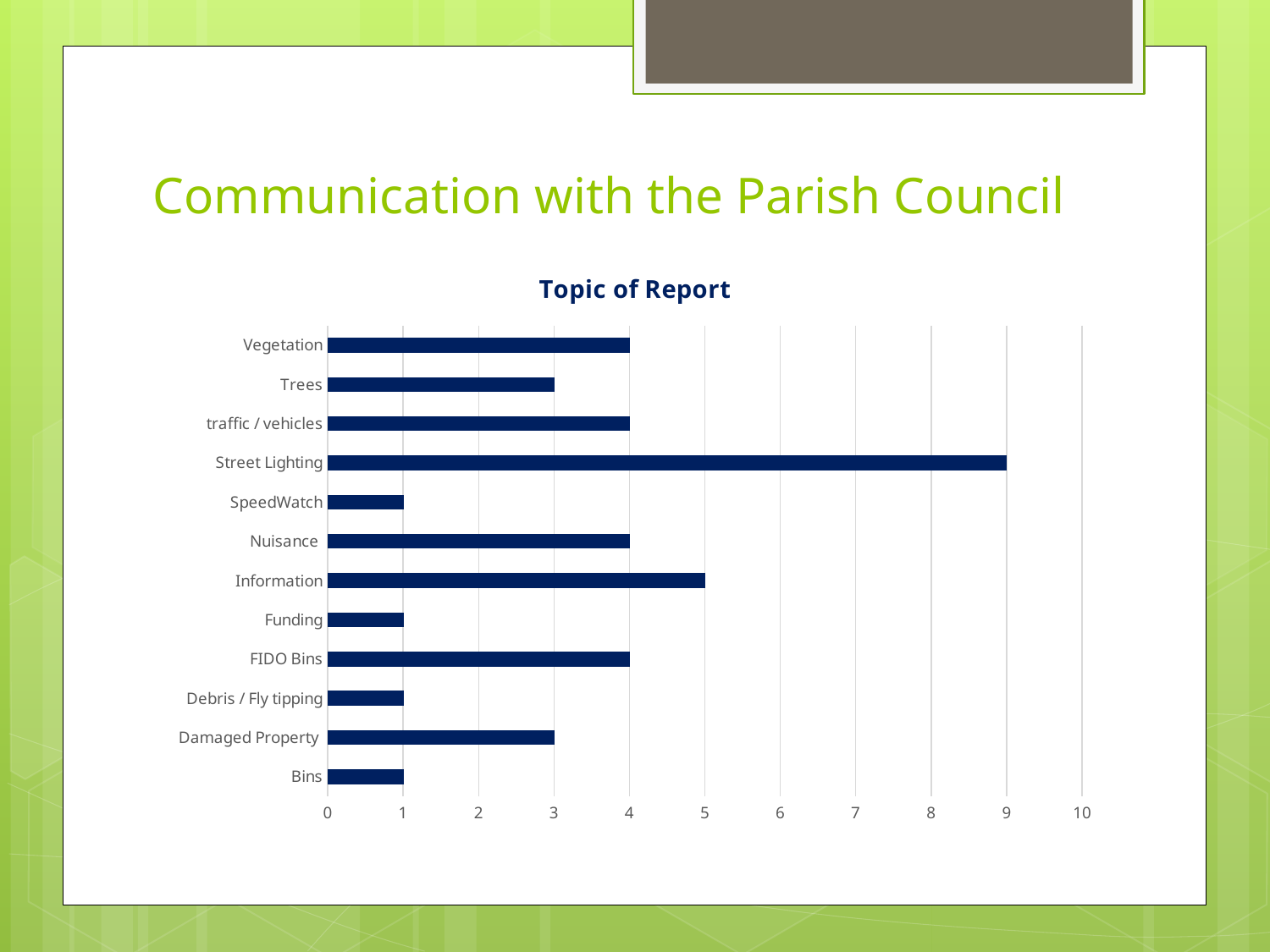
Is the value for Street Lighting greater or less than 8? greater What is the value for Trees? 3 What is the difference between the values for Street Lighting and Information? 4 Which topic has the highest value? Street Lighting What is the value for Damaged Property? 3 What is the difference between the values for Information and SpeedWatch? 4 How many topics are shown on the chart? 12 What is the title of the chart? Topic of Report What is the value for Information? 5 What kind of chart is shown on the slide? Bar chart Which is larger, the value for Vegetation or the value for Trees? Vegetation What is the value for Street Lighting? 9